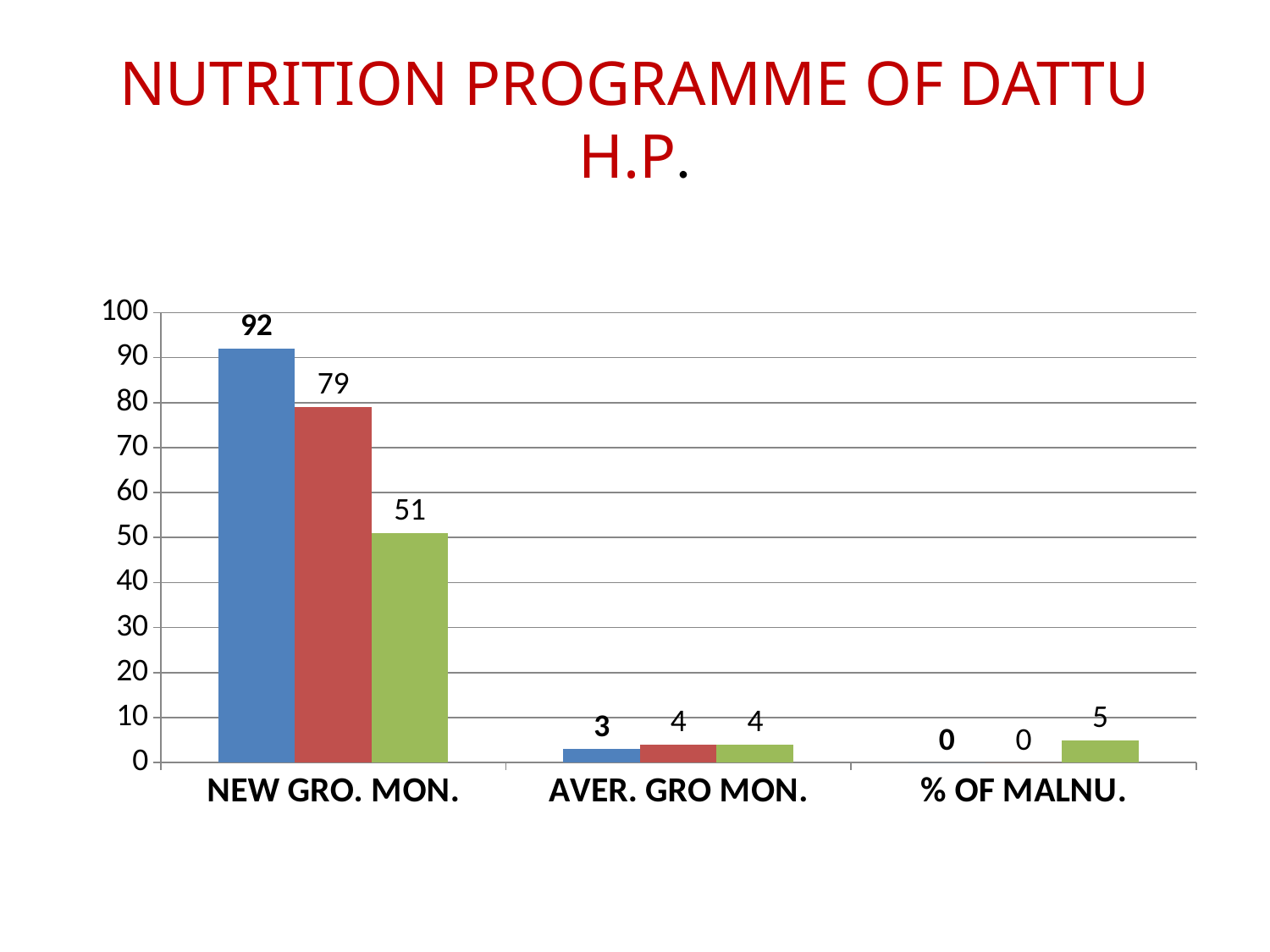
What is the value of the blue bar for NEW GRO. MON.? 92 Which category has the highest blue bar? NEW GRO. MON. Which is larger for NEW GRO. MON., the red bar or the green bar? the red bar How many categories are shown on the x axis of the chart? 3 What is the value of the green bar for % OF MALNU.? 5 What is the difference between the blue and red bars for NEW GRO. MON.? 13 What is the value of the red bar for NEW GRO. MON.? 79 What is the value of the green bar for NEW GRO. MON.? 51 What type of chart is shown on the slide? bar chart What is the title of the slide containing the chart? NUTRITION PROGRAMME OF DATTU H.P. What is the value of the blue bar for AVER. GRO MON.? 3 What is the value of the blue bar for % OF MALNU.? 0